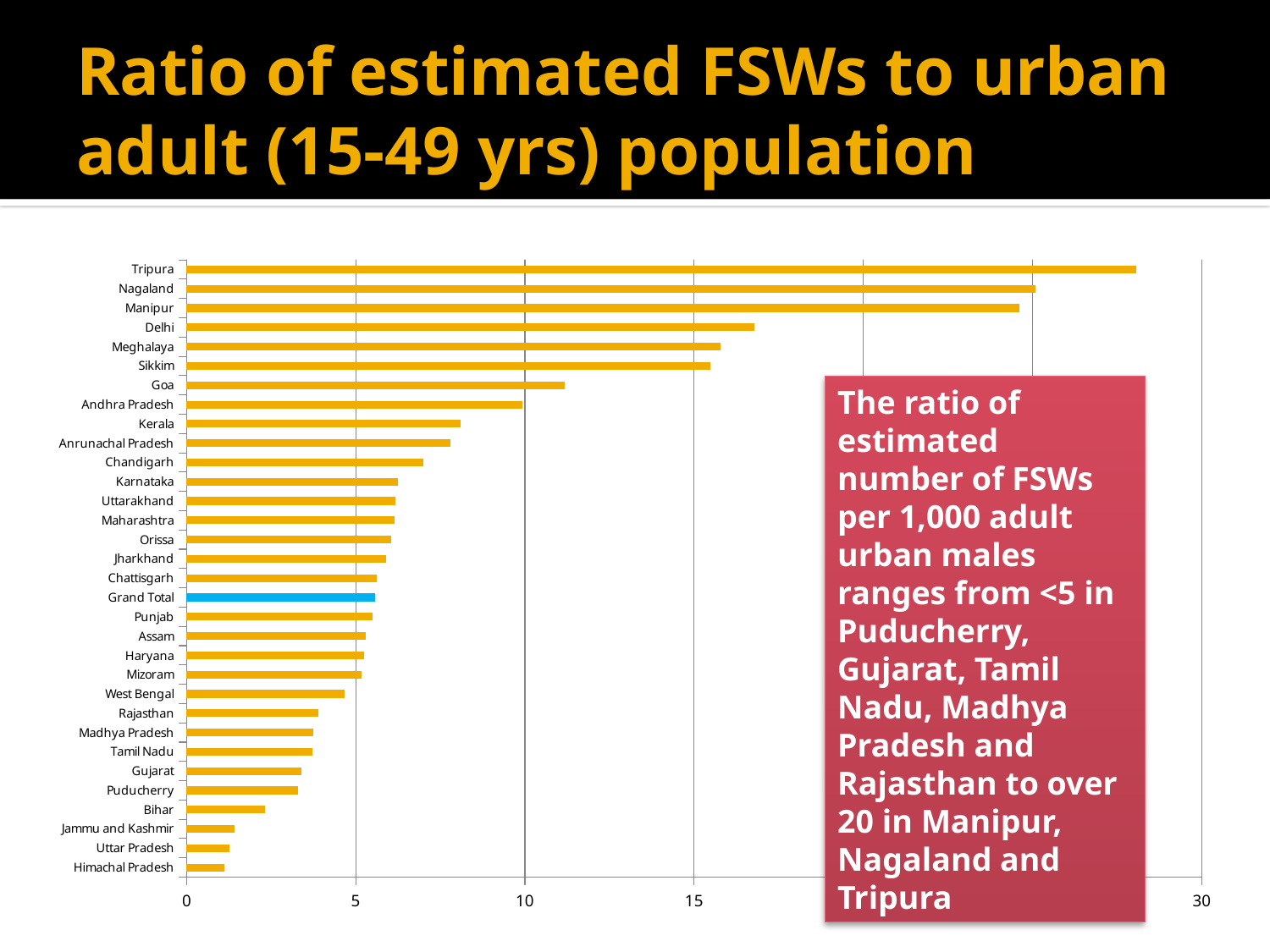
Which bar in the chart is shown in a different colour (blue) from the others? Grand Total Which has the larger value, Tripura or Nagaland? Tripura Which category has the highest ratio in the chart? Tripura Is the value for Delhi greater or less than 15? greater Which has the larger value, Delhi or Goa? Delhi Is the value for Chandigarh greater or less than 5? greater Is the value for Kerala greater or less than 10? less What kind of chart is shown on the slide? bar chart Which category has the lowest ratio in the chart? Himachal Pradesh How many bars are plotted in the chart? 32